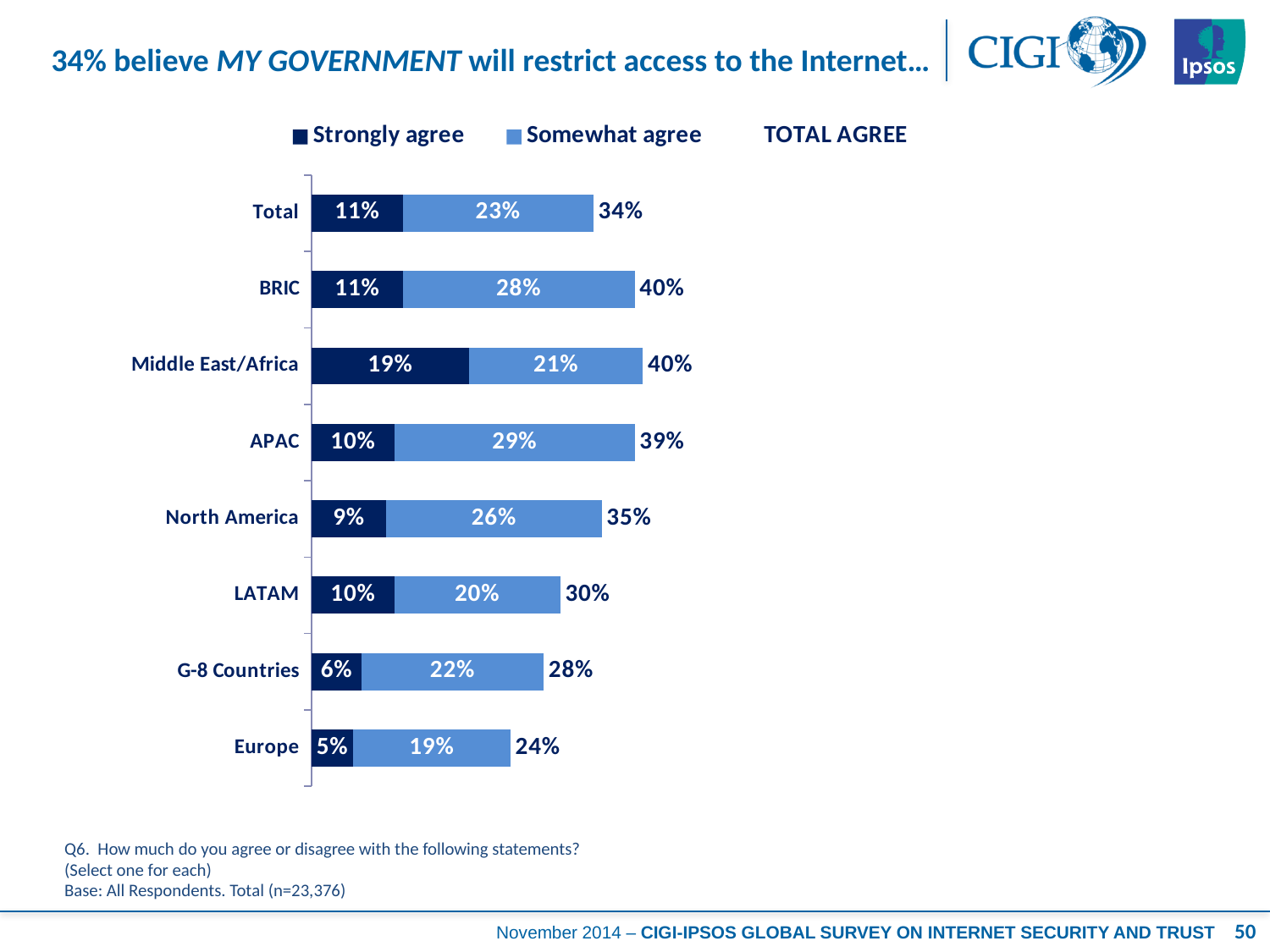
What is the total of the stacked bar for LATAM? 30% Which category has the highest Strongly agree value? Middle East/Africa What is the difference between the Somewhat agree values for BRIC and LATAM? 8% What is the Somewhat agree value for APAC? 29% What kind of chart is shown on the slide? Bar chart Which category has the lowest TOTAL AGREE value? Europe What is the TOTAL AGREE value for Europe? 24% Which has a larger TOTAL AGREE value, North America or G-8 Countries? North America How many series does the legend list? 3 Which series is shown in the darker blue colour? Strongly agree How many categories are shown on the chart? 8 What is the Strongly agree value for Middle East/Africa? 19%